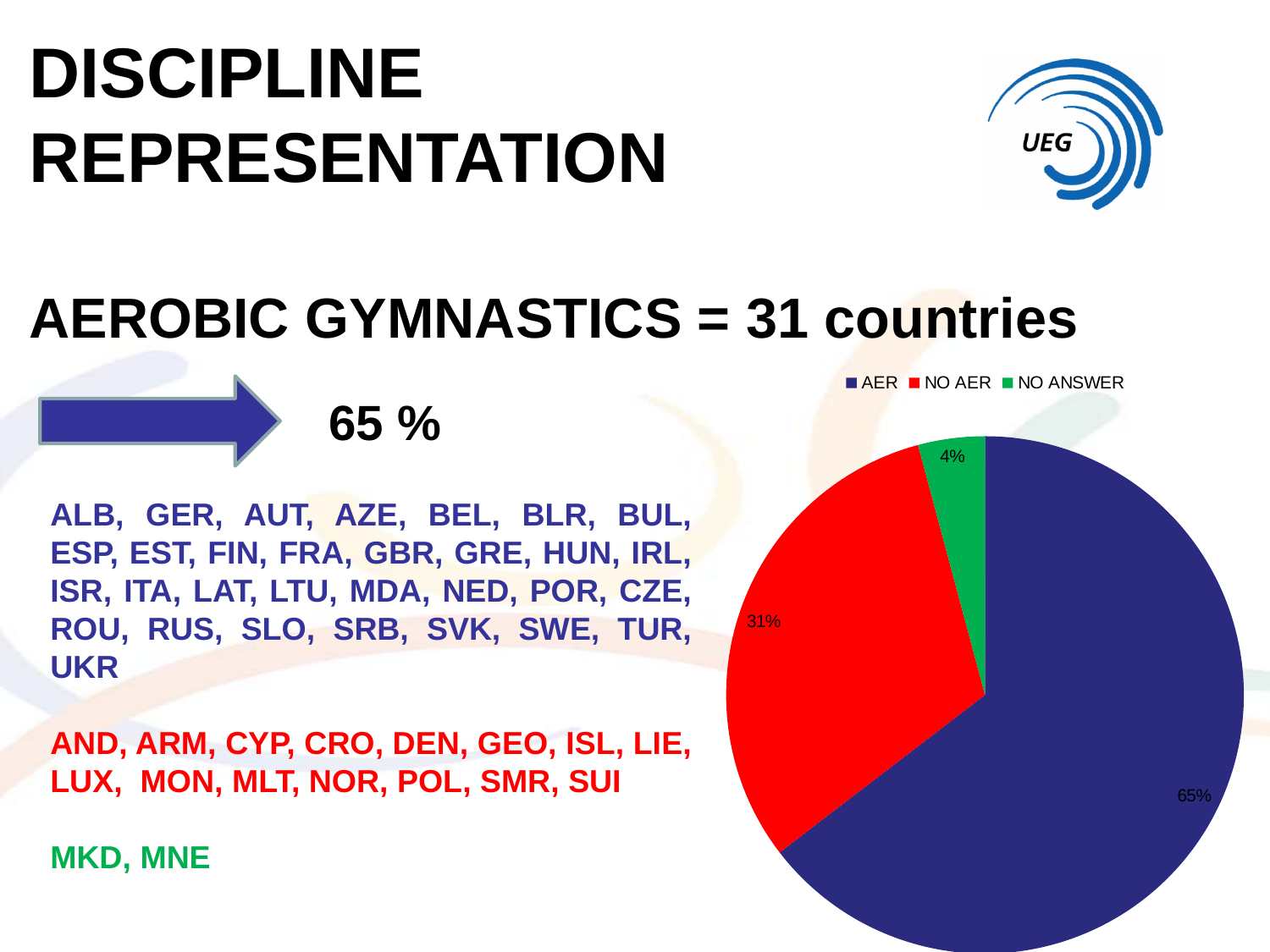
Which category has the largest slice of the pie? AER What kind of chart is shown on the slide? pie chart Which category has the smallest slice of the pie? NO ANSWER What percentage of the pie does the NO ANSWER slice represent? 4% How many entries does the legend list? 3 What colour is the NO ANSWER slice in the pie chart? green What colour is the AER slice in the pie chart? dark blue What is the difference in percentage points between the AER and NO AER slices? 34 Which slice is larger, NO AER or NO ANSWER? NO AER How many slices does the pie chart have? 3 What percentage of the pie does the AER slice represent? 65% What percentage of the pie does the NO AER slice represent? 31%